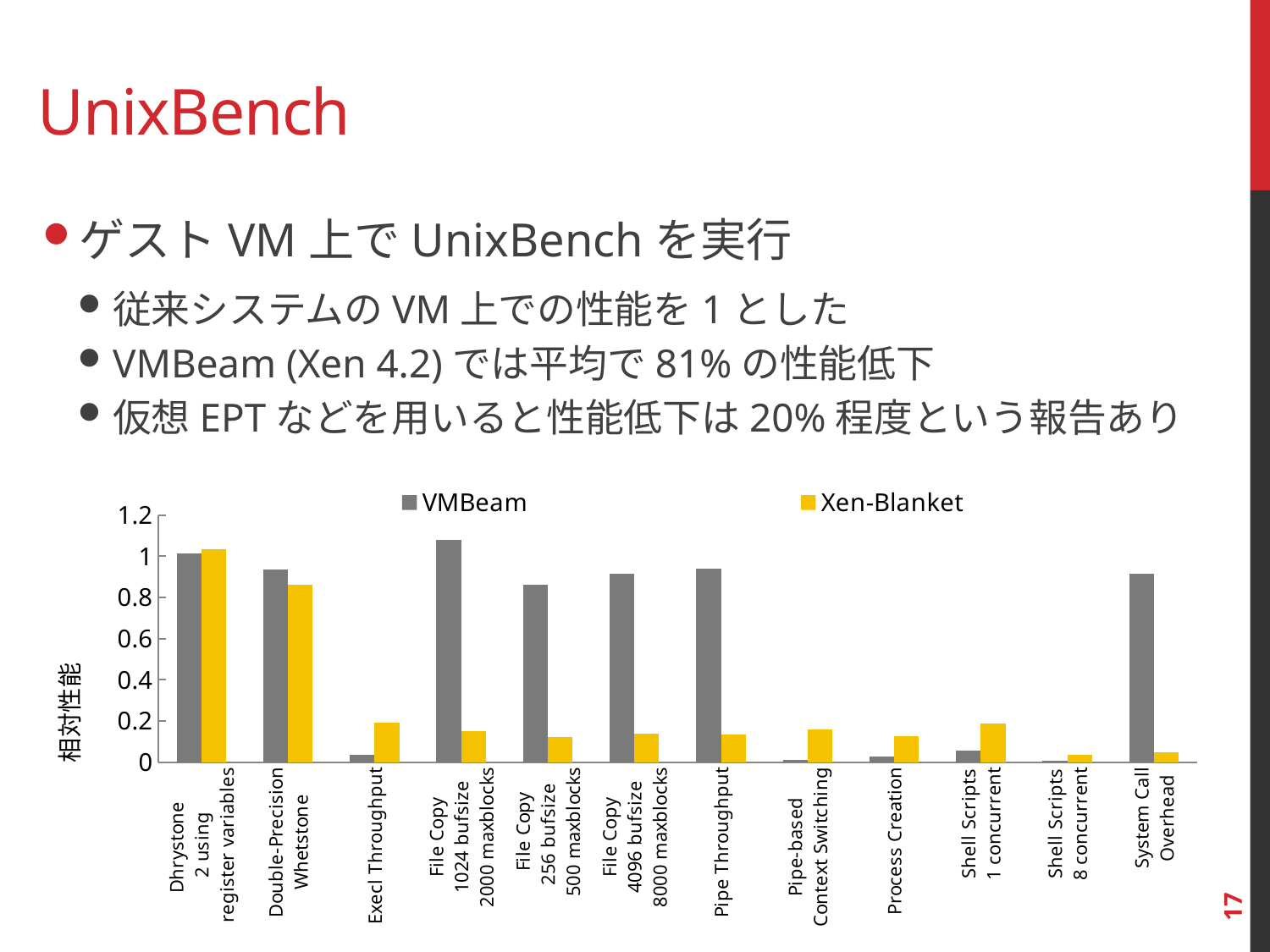
Is the VMBeam value for File Copy 1024 bufsize 2000 maxblocks greater or less than 1? greater For which category is the Xen-Blanket value highest? Dhrystone 2 using register variables How many series does the chart legend list? 2 How many benchmark categories are shown on the x axis of the chart? 12 For Execl Throughput, which series has the larger value, VMBeam or Xen-Blanket? Xen-Blanket Is the Xen-Blanket value for Pipe Throughput greater or less than 0.2? less What is the label of the vertical axis of the chart? 相対性能 What kind of chart is shown on the slide? bar chart Which series is drawn in yellow in the chart? Xen-Blanket Is the VMBeam value for System Call Overhead greater or less than 0.8? greater For System Call Overhead, which series has the larger value, VMBeam or Xen-Blanket? VMBeam For which category is the VMBeam value highest? File Copy 1024 bufsize 2000 maxblocks